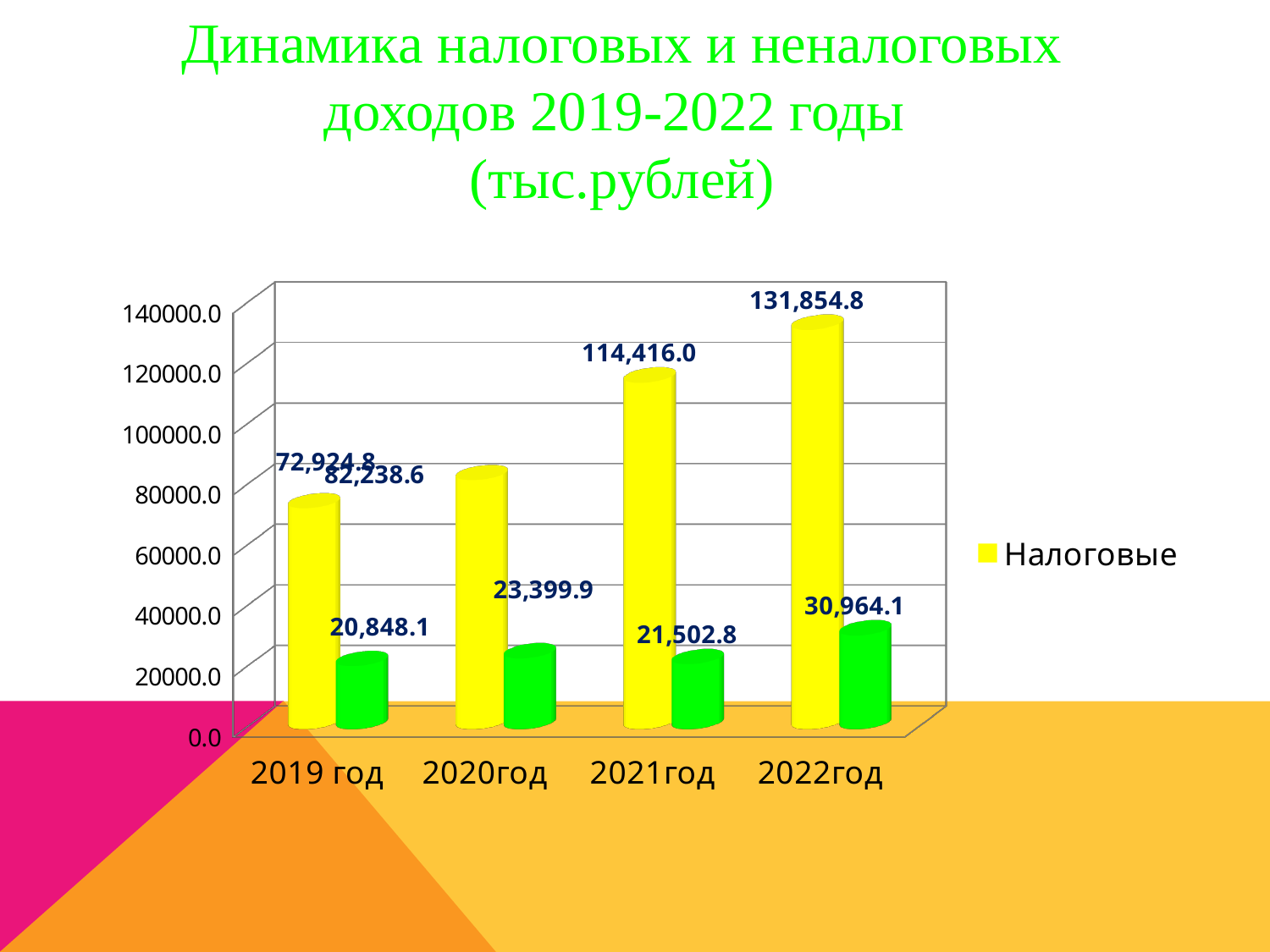
What is the value of the green bar for 2021год? 21,502.8 What is the value of the Налоговые bar for 2022год? 131,854.8 In which year is the green bar lowest? 2019 год What is the difference between the Налоговые values for 2022год and 2021год? 17,438.8 Is the Налоговые value for 2021год greater or less than 100000.0? greater What is the value of the green bar for 2020год? 23,399.9 In which year is the Налоговые value highest? 2022год What is the value of the Налоговые bar for 2019 год? 72,924.8 What kind of chart is shown on the slide? bar chart Which is larger: the green bar for 2020год or the green bar for 2021год? 2020год How many years are shown on the x axis? 4 Do the Налоговые values rise or fall from 2019 год to 2022год? rise